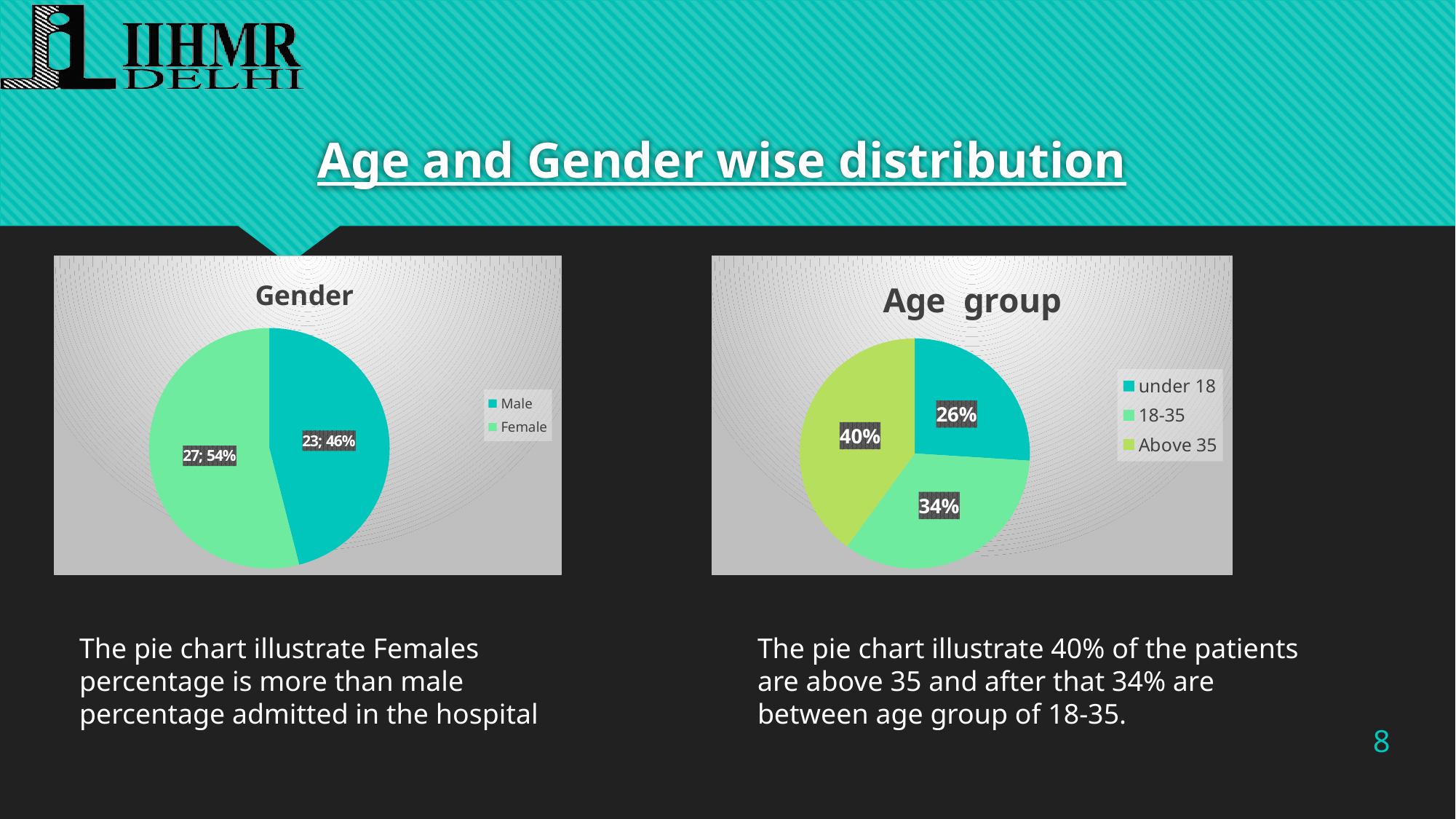
In the Age group chart, what is the difference between the Above 35 share and the under 18 share? 14% In the Age group chart, what percentage of patients are under 18? 26% In the Age group chart, how many age groups are shown? 3 In the Age group chart, which age group has the largest share? Above 35 In the Age group chart, which age group has the smallest share? under 18 In the Gender chart, what is the difference in count between Female and Male patients? 4 In the Gender chart, which category has the larger share? Female In the Gender chart, what is the total number of patients across both categories? 50 In the Gender chart, how many patients are Male? 23 In the Gender chart, what percentage of patients are Female? 54% In the Age group chart, what percentage of patients are in the 18-35 group? 34% What kind of chart is the Gender chart? Pie chart